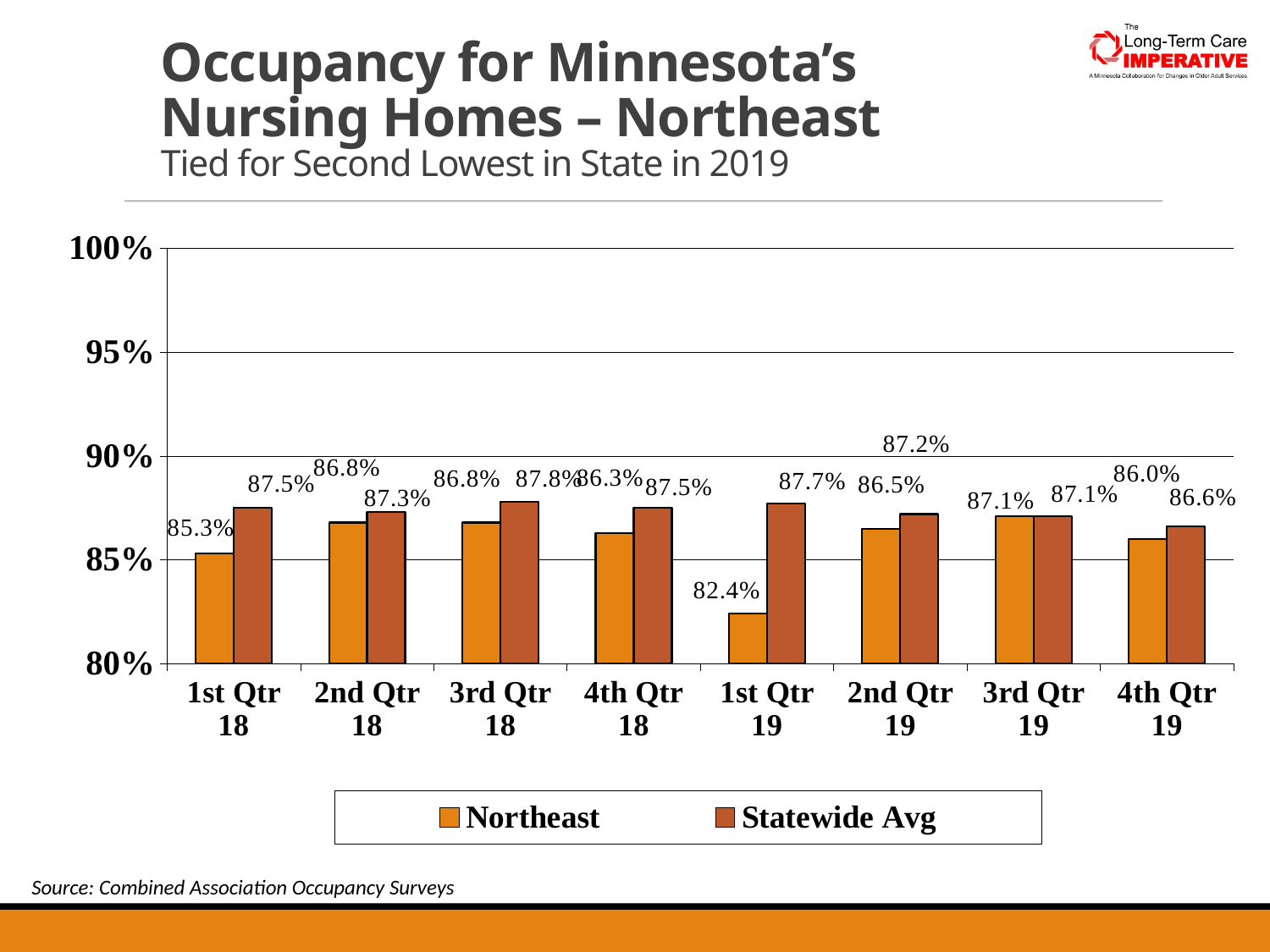
In which quarter is the Northeast occupancy lowest? 1st Qtr 19 How many series does the legend list? 2 What is the Northeast occupancy value for 1st Qtr 19? 82.4% How many quarters are shown on the x axis? 8 In which quarter is the Northeast occupancy highest? 3rd Qtr 19 What is the Northeast value for 1st Qtr 18? 85.3% In 4th Qtr 19, which is larger: the Northeast value or the Statewide Avg value? Statewide Avg What kind of chart is shown on the slide? bar chart What are the two series named in the legend? Northeast and Statewide Avg What is the Statewide Avg value for 3rd Qtr 18? 87.8% What is the difference between the Statewide Avg and Northeast values in 1st Qtr 19? 5.3 percentage points Is the Northeast value for 1st Qtr 19 greater or less than 85%? less